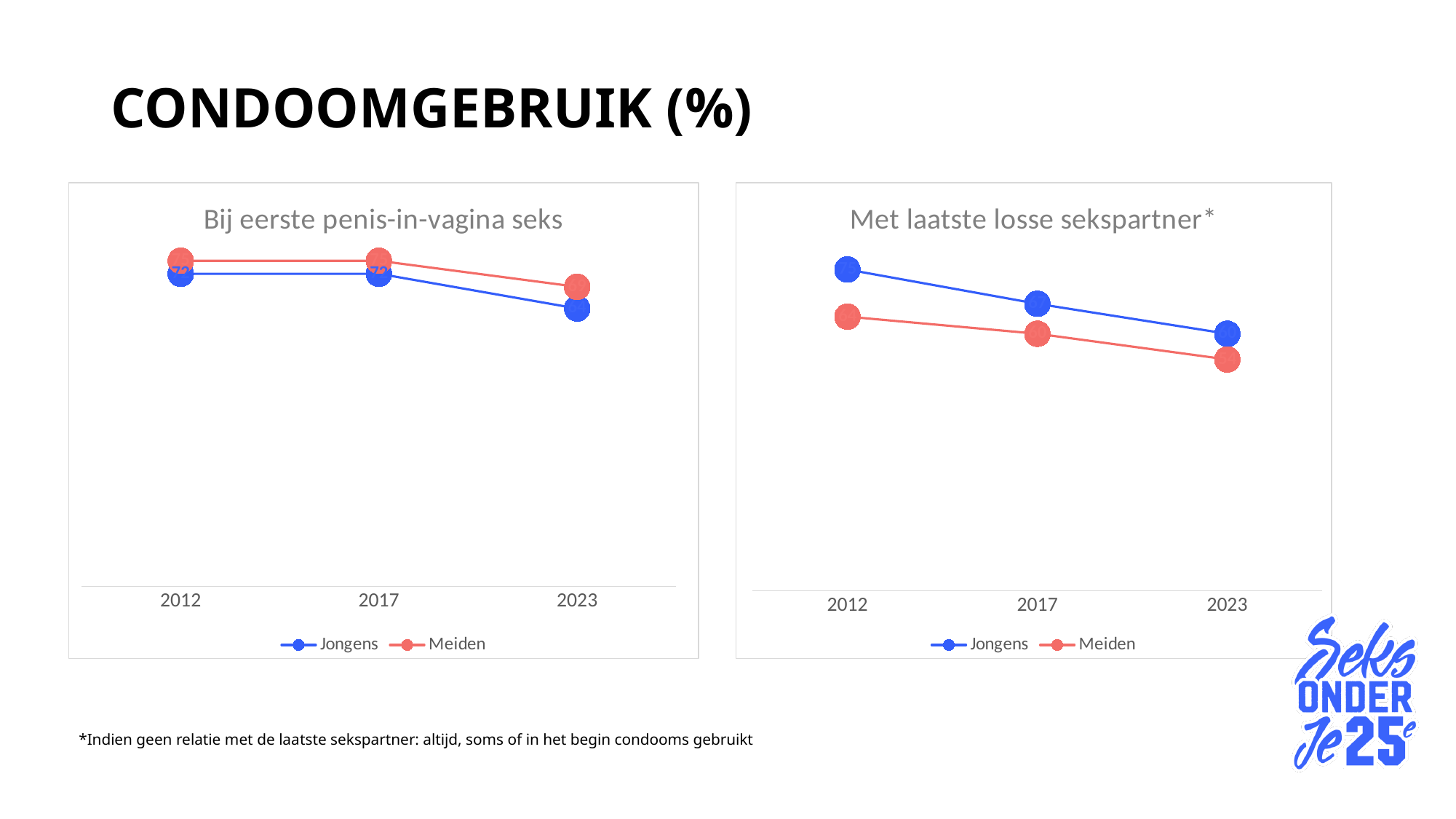
What are the two legend entries in the chart titled "Met laatste losse sekspartner*"? Jongens and Meiden What kind of chart is the chart titled "Bij eerste penis-in-vagina seks"? line chart In the chart titled "Bij eerste penis-in-vagina seks", which series is higher in 2023, Jongens or Meiden? Meiden In the chart titled "Met laatste losse sekspartner*", how many years are shown on the x axis? 3 In the chart titled "Bij eerste penis-in-vagina seks", in which year is the value for Jongens lowest? 2023 In the chart titled "Met laatste losse sekspartner*", which series is higher in 2012, Jongens or Meiden? Jongens What kind of chart is the chart titled "Met laatste losse sekspartner*"? line chart In the chart titled "Met laatste losse sekspartner*", in which year is the value for Meiden lowest? 2023 In the chart titled "Bij eerste penis-in-vagina seks", how many series does the legend list? 2 In the chart titled "Met laatste losse sekspartner*", in which year is the value for Jongens highest? 2012 In the chart titled "Met laatste losse sekspartner*", do the values for Jongens rise or fall from 2012 to 2023? fall In the chart titled "Bij eerste penis-in-vagina seks", do the values for Jongens rise or fall from 2017 to 2023? fall